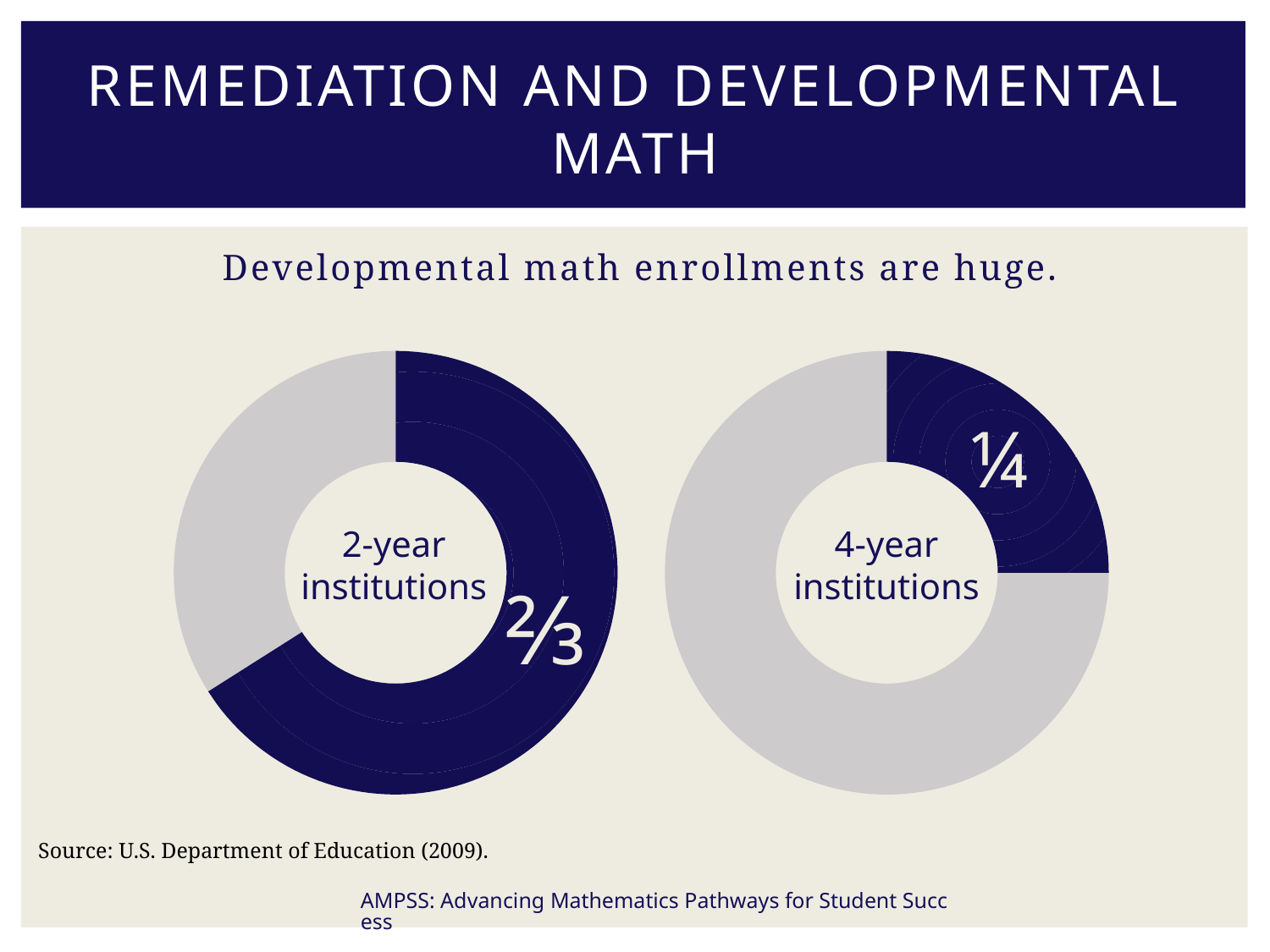
Which chart has the larger dark-blue share, 2-year institutions or 4-year institutions? 2-year institutions How many segments does the 4-year institutions chart have? 2 What is the subtitle text above the charts? Developmental math enrollments are huge. What is the label in the centre of the left chart? 2-year institutions What kind of chart is used for the 2-year institutions data? Donut (pie) chart In the 4-year institutions chart, what share of the ring is shown in dark blue? ¼ How many charts are shown on the slide? 2 In the 4-year institutions chart, is the dark-blue share greater or less than half of the ring? less Which chart has the smaller dark-blue share, 2-year institutions or 4-year institutions? 4-year institutions In the 2-year institutions chart, what share of the ring is shown in dark blue? ⅔ In the 2-year institutions chart, is the dark-blue share greater or less than half of the ring? greater